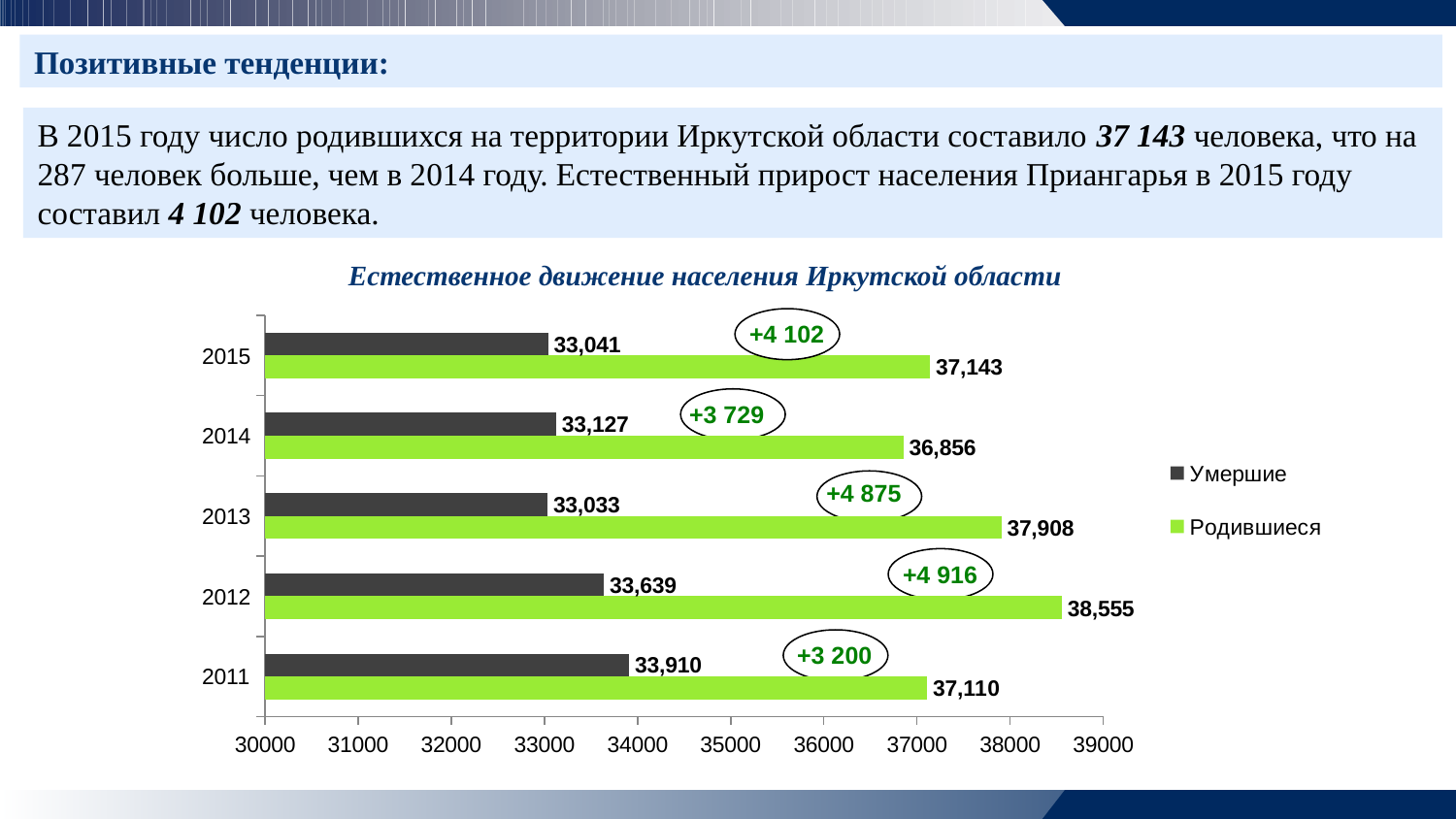
What type of chart is shown on the slide? bar chart How many series does the legend list? 2 Is the value for Родившиеся in 2012 greater or less than 38000? greater What is the value for Умершие in 2011? 33,910 What is the value for Родившиеся in 2015? 37,143 How many years are shown on the chart? 5 In which year was the value for Родившиеся the lowest? 2014 In which year was the value for Родившиеся the highest? 2012 What is the value for Родившиеся in 2013? 37,908 What is the difference between Родившиеся and Умершие in 2012? 4,916 Which is larger: Умершие in 2011 or Умершие in 2013? Умершие in 2011 What is the title of the chart? Естественное движение населения Иркутской области